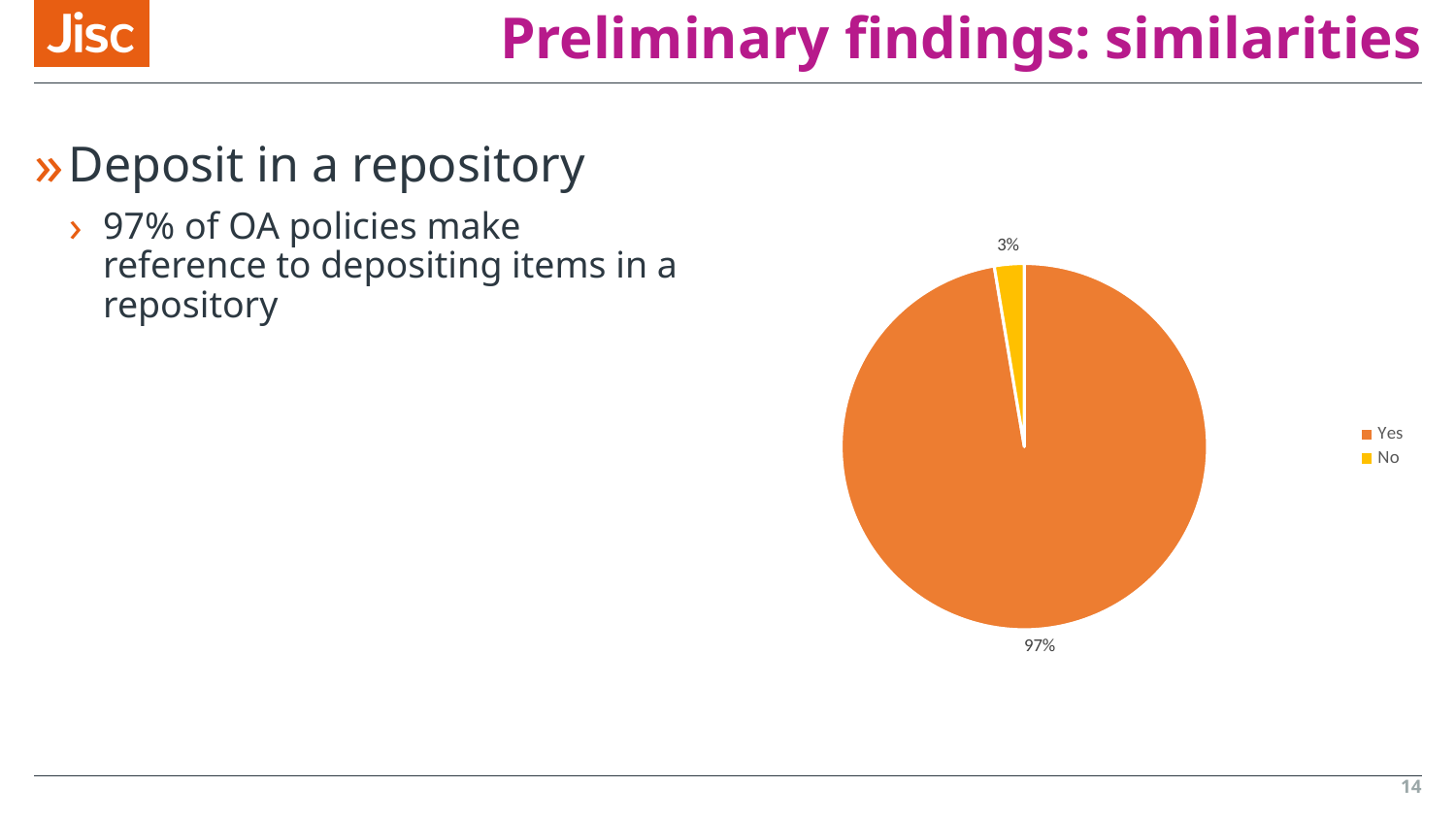
What colour is the "Yes" slice in the pie chart? orange Which slice of the pie is the largest? Yes Which is larger, the "Yes" slice or the "No" slice? Yes What is the difference in percentage points between the "Yes" and "No" slices? 94 What kind of chart is shown on the slide? pie chart What share of the pie does the "No" slice represent? 3% How many entries does the legend list? 2 What share of the pie does the "Yes" slice represent? 97% How many slices does the pie chart have? 2 What colour is the "No" slice in the pie chart? yellow Which slice of the pie is the smallest? No